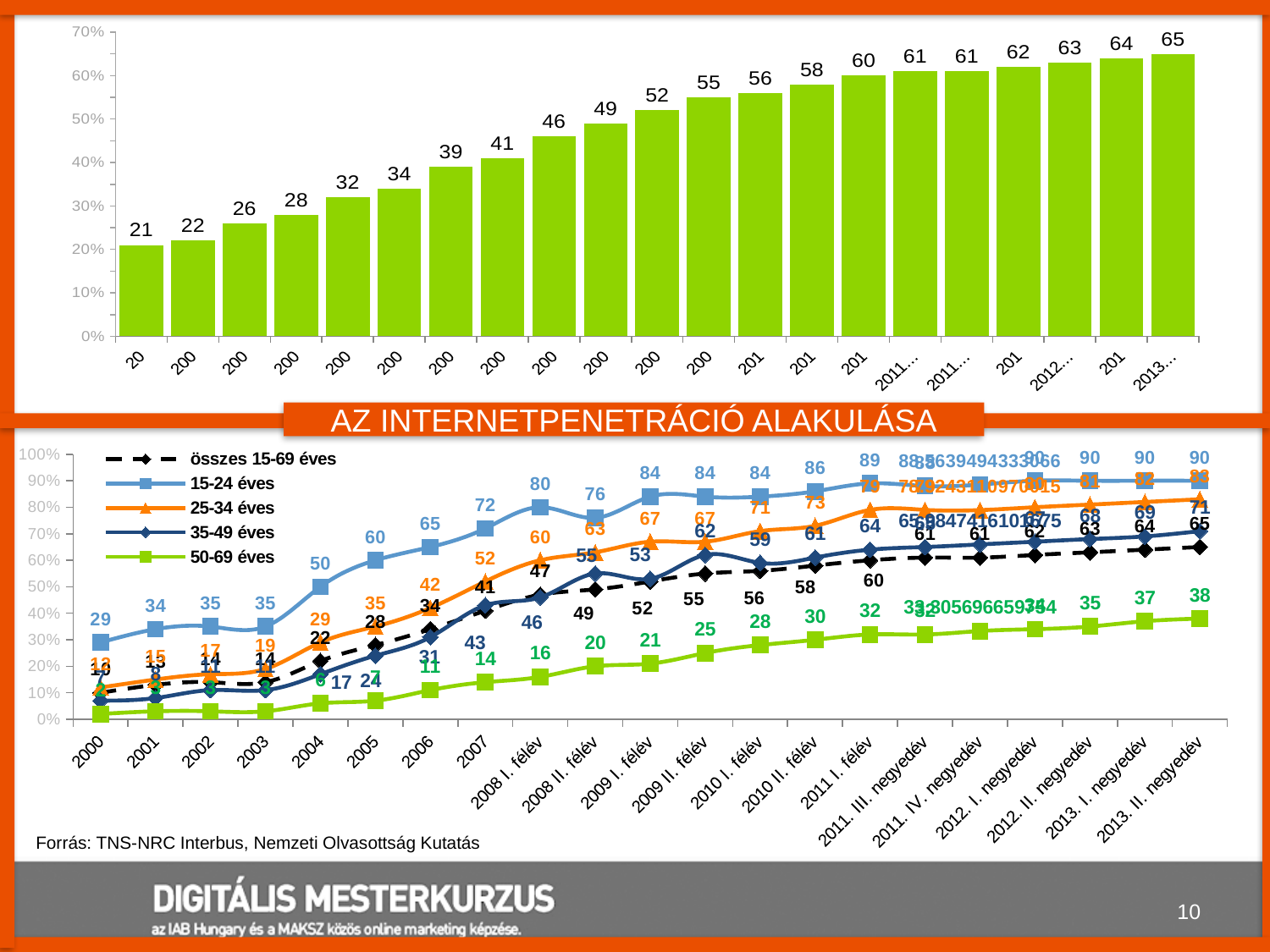
What is the title shown between the two charts? AZ INTERNETPENETRÁCIÓ ALAKULÁSA In the bottom line chart, what is the difference between the 15-24 éves value in 2004 (50) and in 2000 (29)? 21 In the top chart, what is the difference between the last bar (65) and the first bar (21)? 44 In the top chart, what is the highest value shown on a bar? 65 In the bottom line chart, which is larger at 2013. II. negyedév: the 15-24 éves series or the 50-69 éves series? 15-24 éves How many bars does the top chart show? 21 What kind of chart is the top chart on the slide? bar chart How many series does the legend of the bottom line chart list? 5 In the bottom line chart, what is the value for the 15-24 éves series at 2008 I. félév? 80 In the top chart, do the values rise or fall from left to right? rise In the top chart, what is the lowest value shown on a bar? 21 In the bottom line chart, what is the value for the 50-69 éves series at 2013. II. negyedév? 38